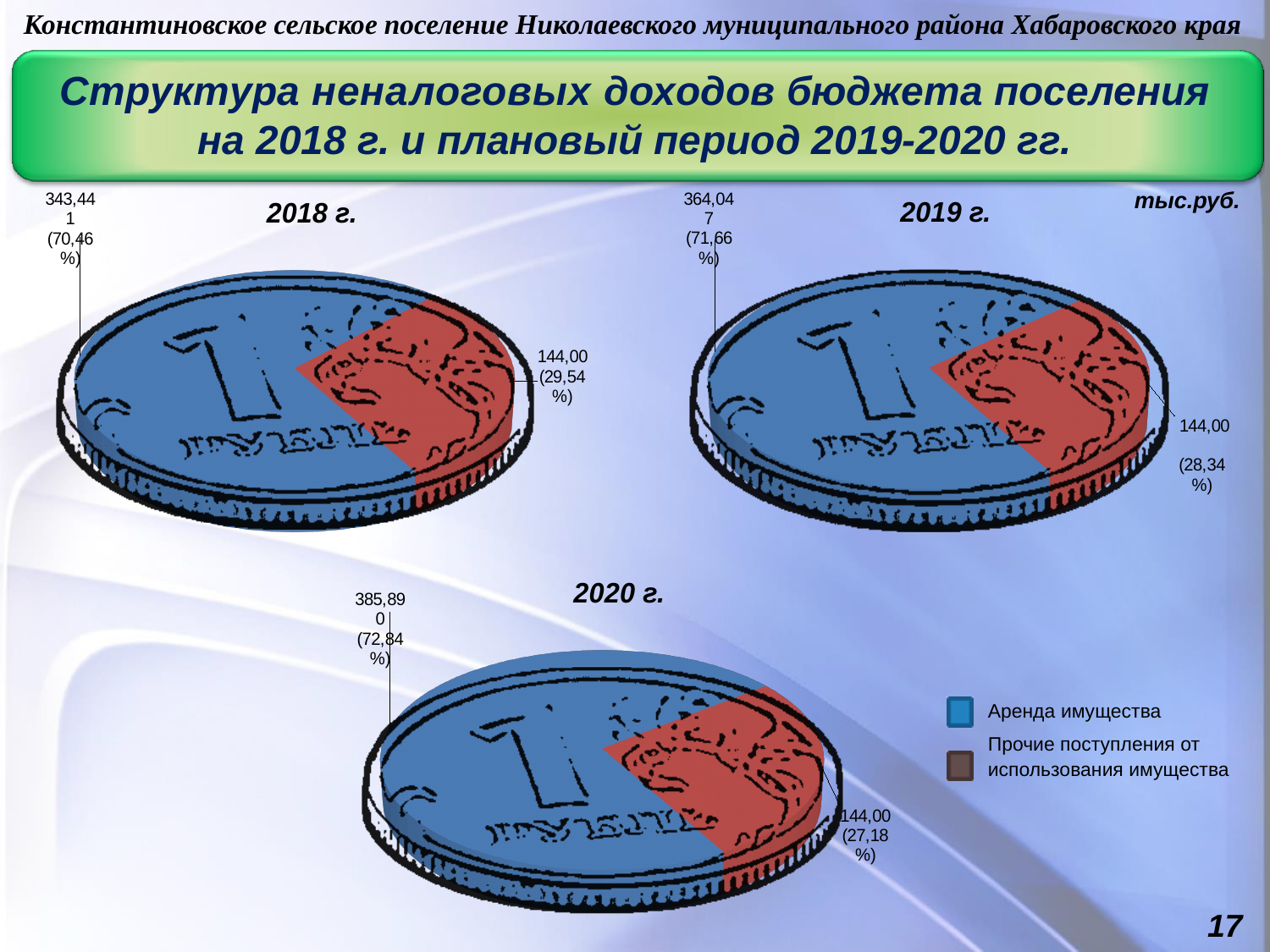
What kind of chart is used for the 2018 г. data? Pie chart In the 2020 г. chart, which is larger: Аренда имущества or Прочие поступления от использования имущества? Аренда имущества How many categories does the legend list? 2 In the 2018 г. chart, what is the value for Аренда имущества? 343,441 In the 2020 г. chart, what share of the pie is Прочие поступления от использования имущества? 27,18% In the 2019 г. chart, what share of the pie is Аренда имущества? 71,66% In the 2018 г. chart, what share of the pie is Прочие поступления от использования имущества? 29,54% In the 2019 г. chart, what is the value for Аренда имущества? 364,047 In the 2018 г. chart, which category has the smallest slice? Прочие поступления от использования имущества In the 2019 г. chart, which category has the largest slice? Аренда имущества In the 2020 г. chart, what is the value for Аренда имущества? 385,890 In the 2020 г. chart, what is the value for Прочие поступления от использования имущества? 144,00